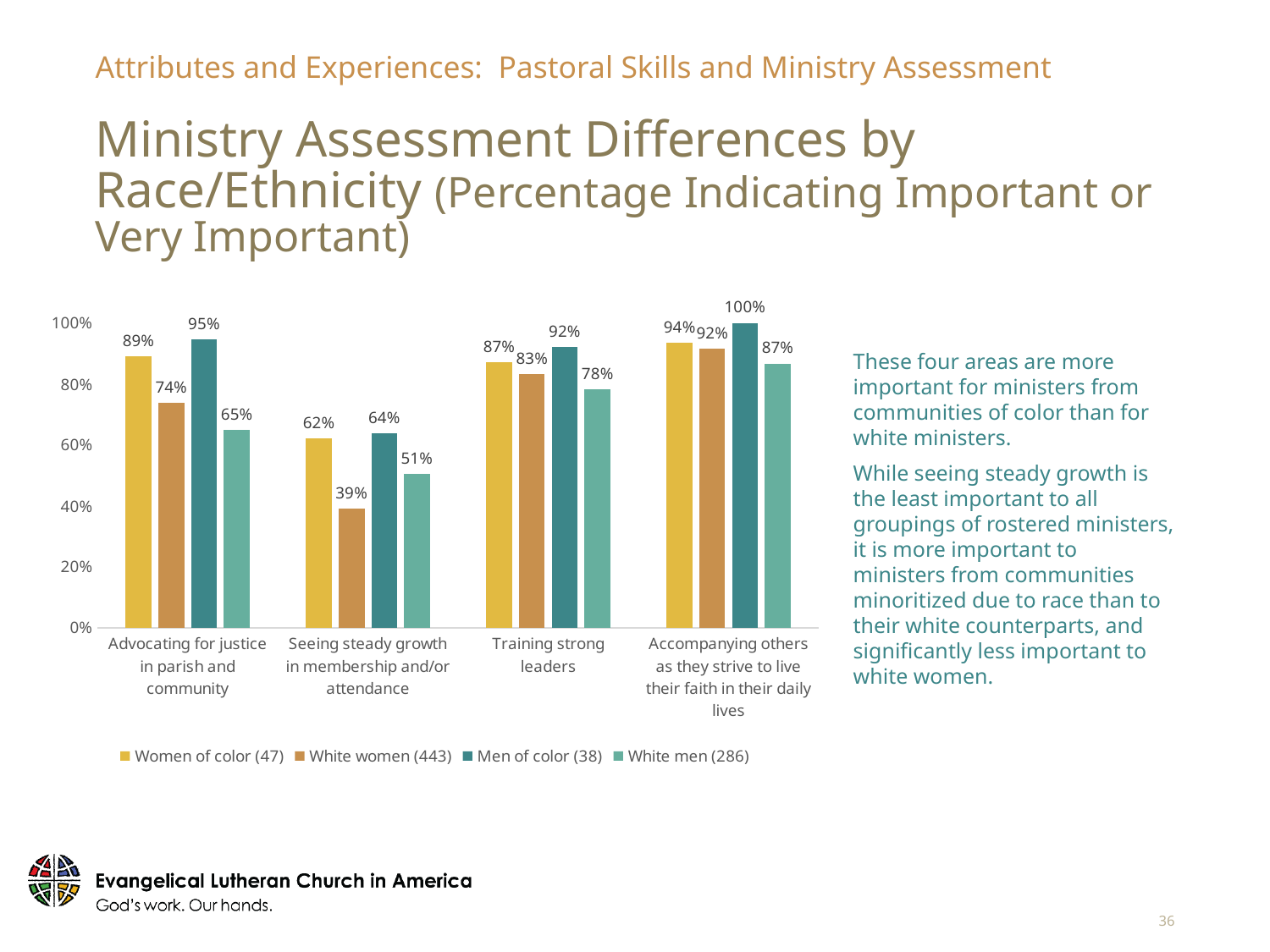
Which is larger for 'Training strong leaders': the value for Women of color or the value for White women? Women of color What is the difference between the Women of color and White women values for 'Advocating for justice in parish and community'? 15 percentage points What is the value for White women for 'Seeing steady growth in membership and/or attendance'? 39% Is the value for White men for 'Seeing steady growth in membership and/or attendance' greater or less than 60%? less Which group has the lowest value for 'Seeing steady growth in membership and/or attendance'? White women What kind of chart is shown on the slide? Bar chart Which group has the highest value for 'Accompanying others as they strive to live their faith in their daily lives'? Men of color How many categories are shown on the x axis of the chart? 4 What percentage of Men of color rated 'Advocating for justice in parish and community' as important or very important? 95% According to the legend, how many White women respondents are included? 443 What is the value for White men for 'Training strong leaders'? 78% How many series does the legend list? 4